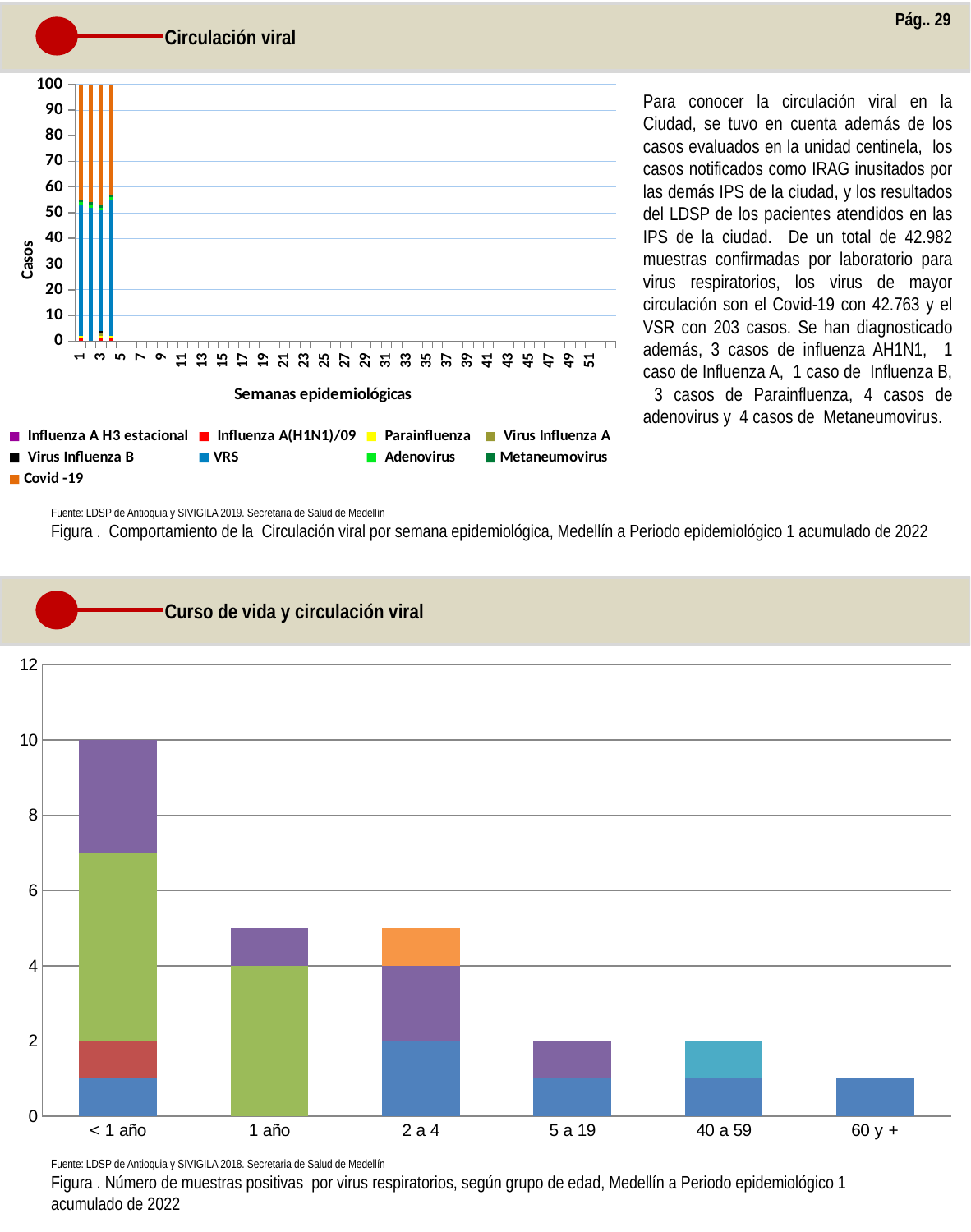
In the bottom chart (Curso de vida y circulación viral), which bar is taller: 1 año or 5 a 19? 1 año In the bottom chart (Curso de vida y circulación viral), which age group has the tallest bar? < 1 año What is the y-axis title of the top chart (Circulación viral)? Casos In the bottom chart (Curso de vida y circulación viral), is the total for 60 y + greater or less than 2? less What is the x-axis title of the top chart (Circulación viral)? Semanas epidemiológicas In the bottom chart (Curso de vida y circulación viral), which age group has the shortest bar? 60 y + How many series does the legend of the top chart (Circulación viral) list? 9 How many age groups are shown on the x axis of the bottom chart (Curso de vida y circulación viral)? 6 In the bottom chart (Curso de vida y circulación viral), is the total for 2 a 4 greater or less than 4? greater In the bottom chart (Curso de vida y circulación viral), what is the total height of the stacked bar for < 1 año? 10 In the bottom chart (Curso de vida y circulación viral), what is the total height of the stacked bar for 5 a 19? 2 What kind of chart is the bottom chart (Curso de vida y circulación viral)? Stacked bar chart